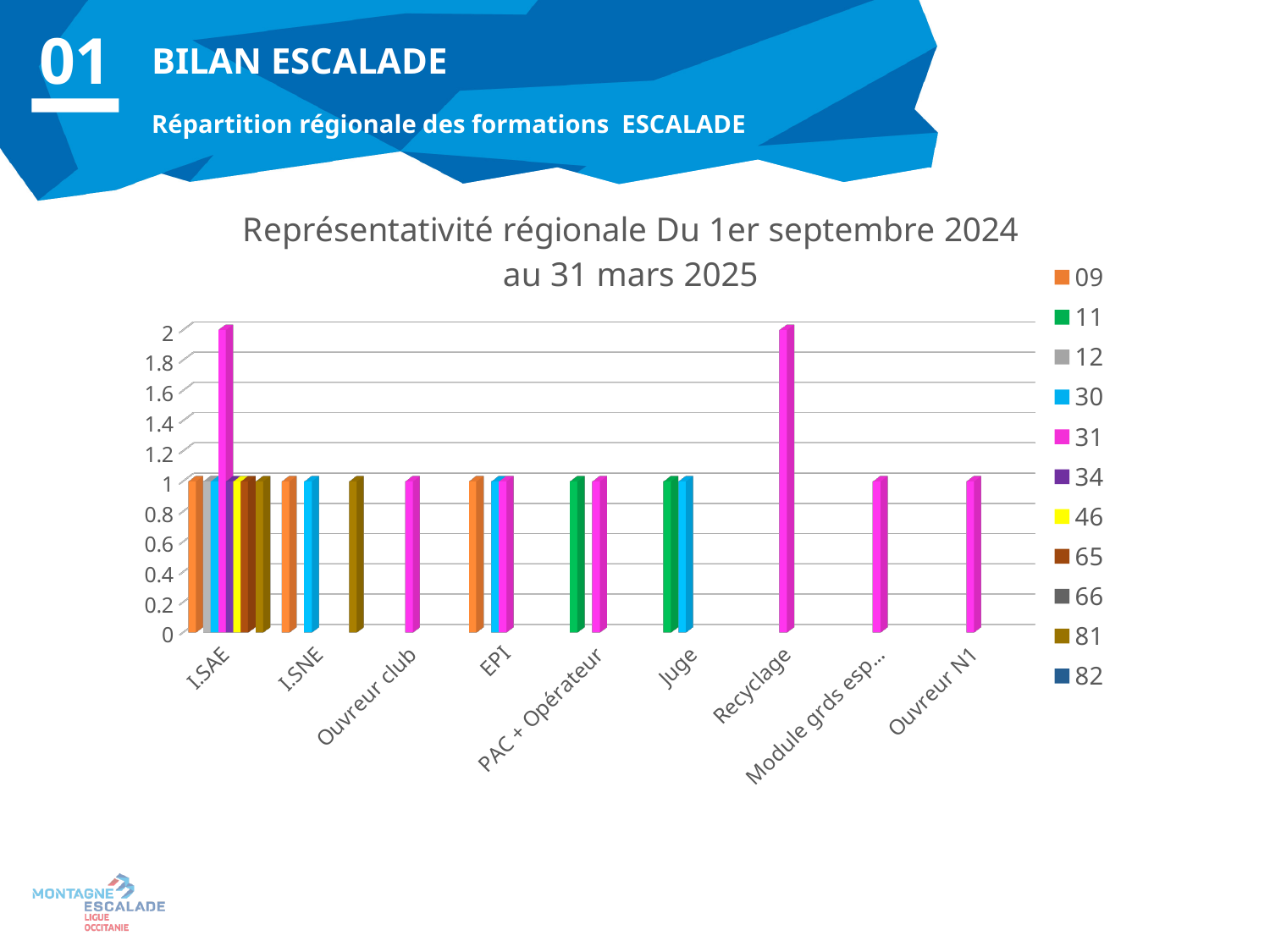
Which category has the largest number of series bars plotted? I.SAE How many series does the legend list? 11 What is the value for series 31 in the Recyclage category? 2 What type of chart is shown on the slide? Bar chart What is the highest value reached by any bar on the chart? 2 Which is larger: the value for series 31 in I.SAE or in Ouvreur N1? I.SAE What is the title of the chart? Représentativité régionale Du 1er septembre 2024 au 31 mars 2025 How many categories are shown on the x axis? 9 What is the difference between the value for series 31 in Recyclage and in Module grds esp...? 1 Is the value for series 31 in Recyclage greater or less than 1.5? greater What is the value for series 31 in the Ouvreur N1 category? 1 What is the value for series 31 in the I.SAE category? 2